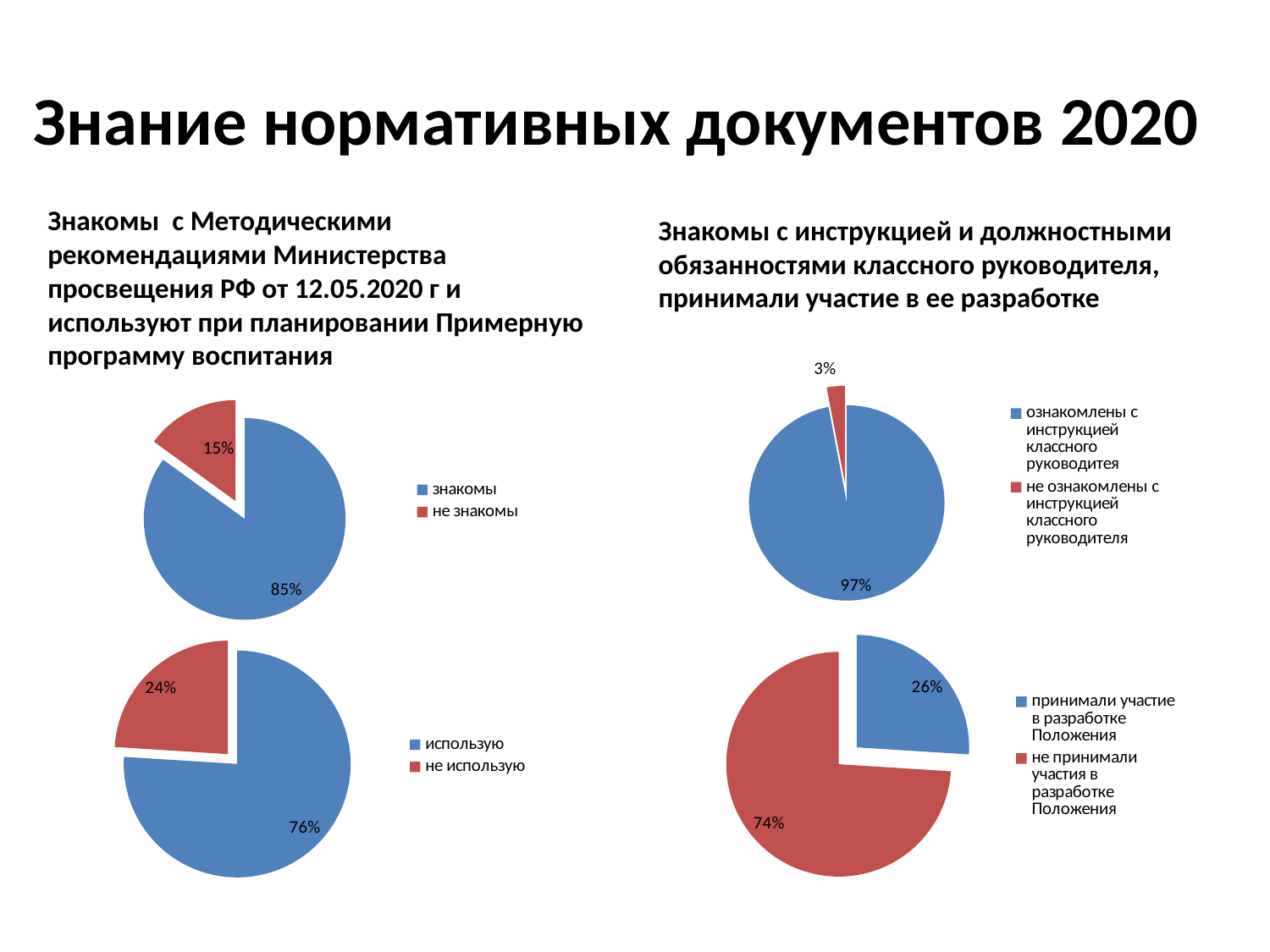
In the bottom-right pie chart, what is the difference in percentage points between the "не принимали участия" and "принимали участие" slices? 48 In the top-left pie chart, what share is labelled "не знакомы"? 15% In the top-right pie chart, what share is labelled "не ознакомлены с инструкцией классного руководителя"? 3% In the top-left pie chart, what is the difference in percentage points between the "знакомы" and "не знакомы" slices? 70 In the bottom-right pie chart, what share is labelled "принимали участие в разработке Положения"? 26% In the top-left pie chart, what share is labelled "знакомы"? 85% What type of chart is used in the top-right chart? pie chart How many pie charts are shown on the slide? 4 In the bottom-left pie chart, what share is labelled "не использую"? 24% How many entries does the legend of the bottom-left chart list? 2 In the bottom-right pie chart, which slice is larger: "принимали участие в разработке Положения" or "не принимали участия в разработке Положения"? не принимали участия в разработке Положения In the bottom-left pie chart, what share is labelled "использую"? 76%